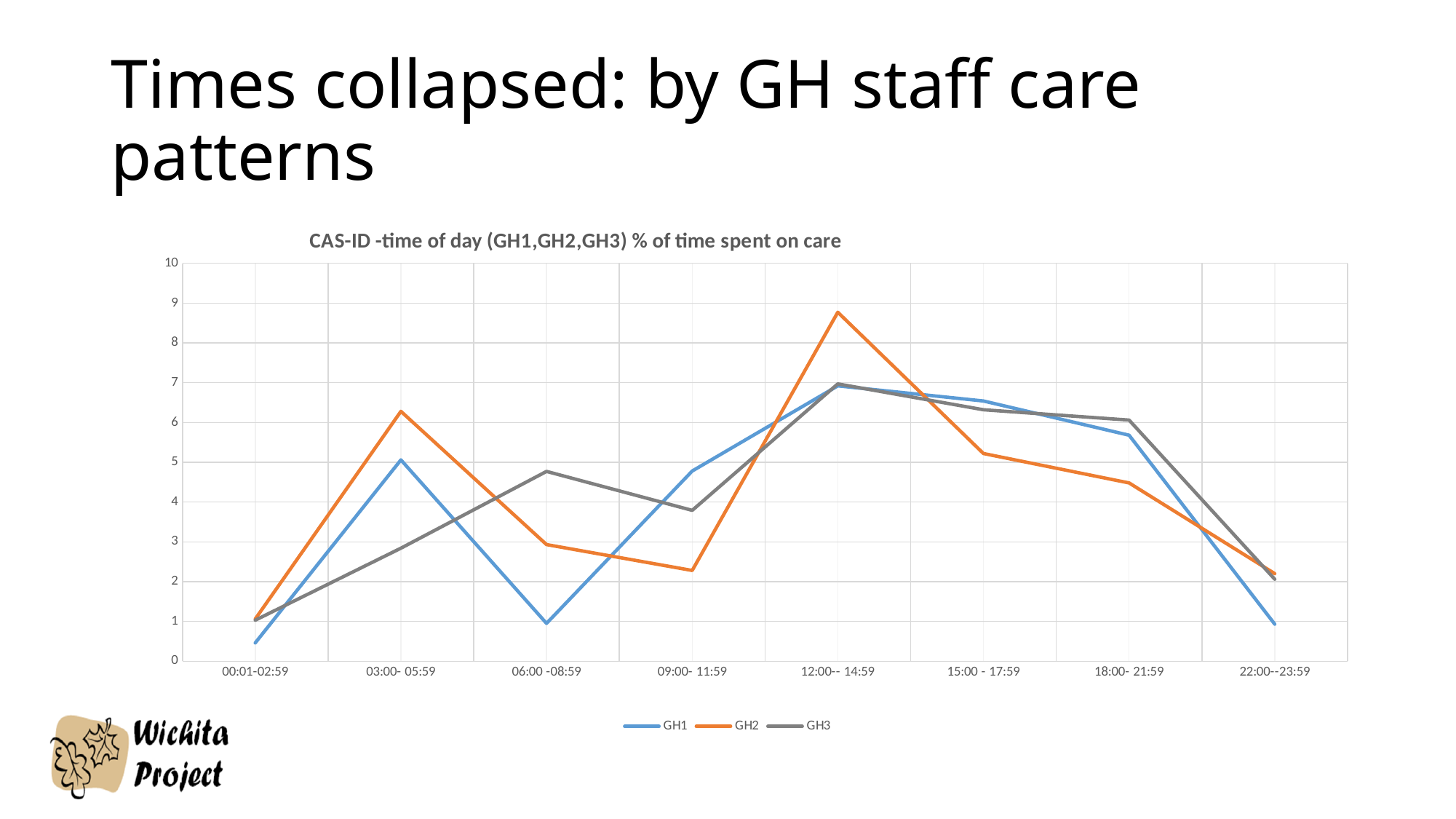
Is the value for GH2 at 12:00-- 14:59 greater or less than 8? greater How many series does the legend list? 3 At which time of day does GH2 reach its highest value? 12:00-- 14:59 At 03:00- 05:59, which series has the larger value, GH1 or GH2? GH2 Is the value for GH3 at 06:00 -08:59 greater or less than 4? greater What is the title of the chart? CAS-ID -time of day (GH1,GH2,GH3) % of time spent on care What kind of chart is shown on the slide? line chart Do the GH3 values rise or fall from 12:00-- 14:59 to 22:00--23:59? fall Is the value for GH1 at 06:00 -08:59 greater or less than 2? less How many time-of-day categories are plotted on the x axis? 8 Which series has the highest value at 12:00-- 14:59? GH2 At which time of day is GH1 at its lowest value? 00:01-02:59